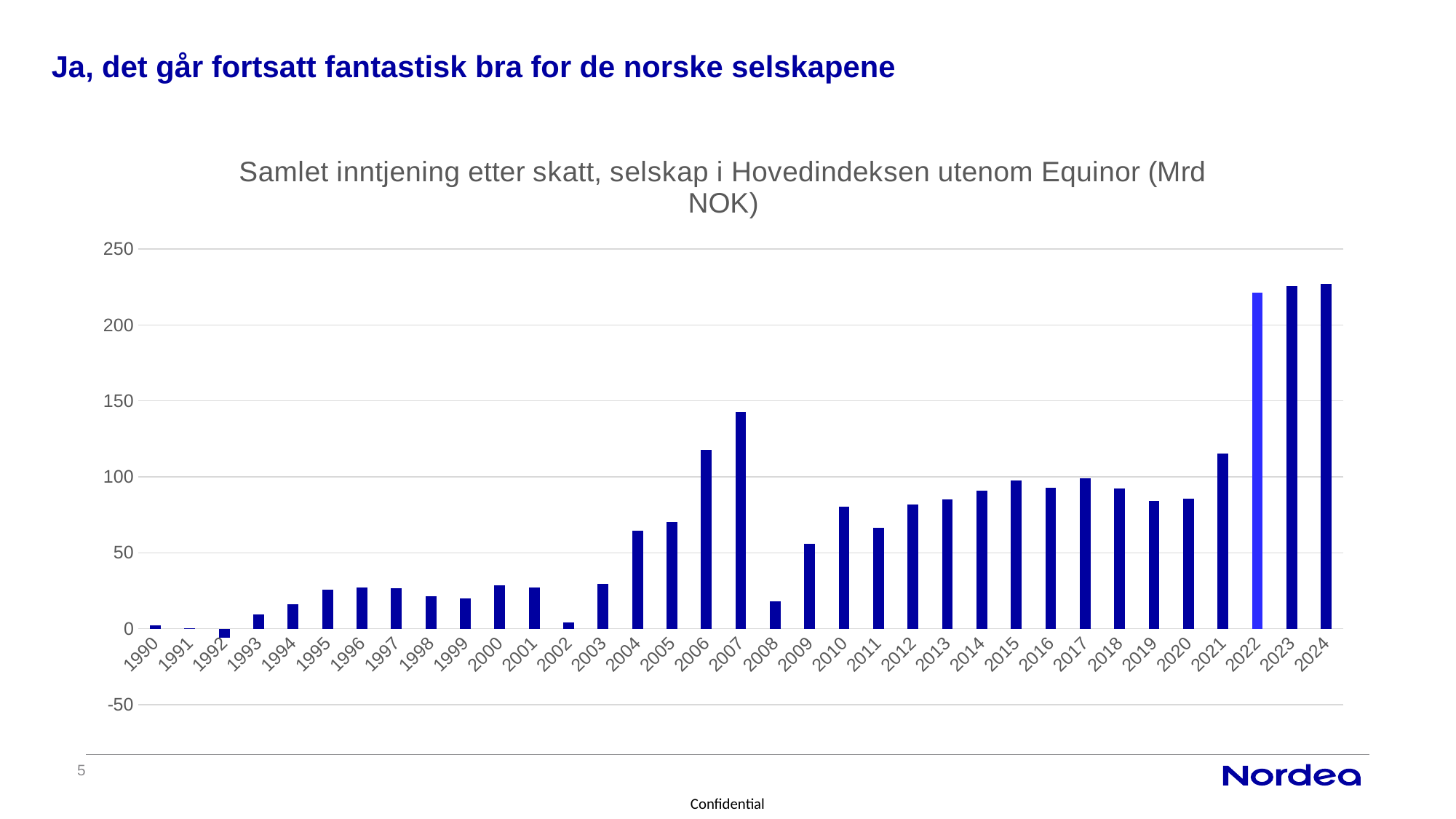
Is the value for 2021 greater or less than 100? greater Which year has the larger value, 2020 or 2021? 2021 Is the value for 2002 greater or less than 50? less Is the value for 2007 greater or less than 100? greater Which year has the lowest value in the chart? 1992 Which year has the larger value, 2008 or 2009? 2009 Which year's bar is drawn in a lighter blue than the others? 2022 Which year has the larger value, 2006 or 2007? 2007 What kind of chart is shown on the slide? bar chart How many years are plotted on the x axis of the chart? 35